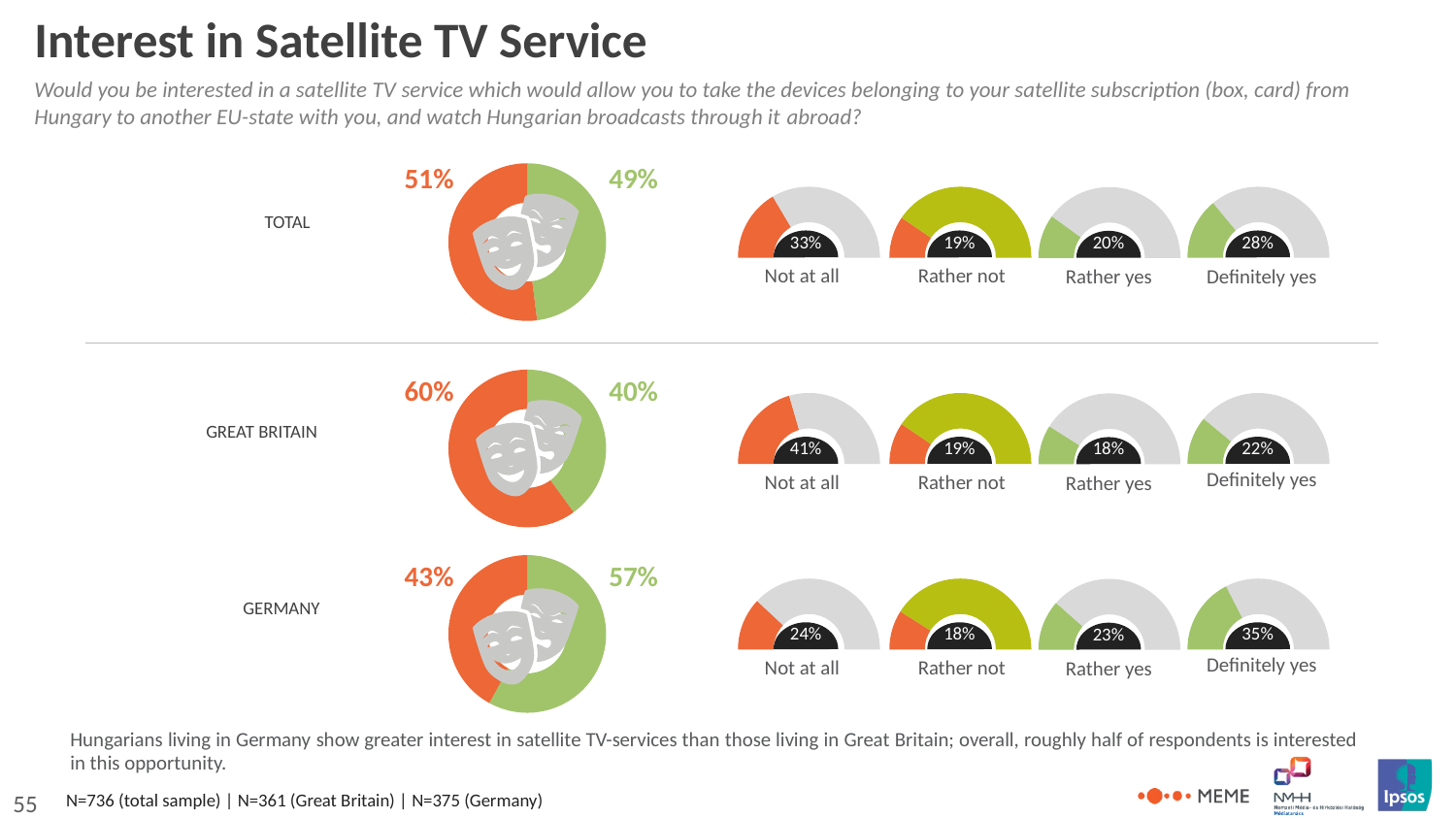
In the GERMANY donut chart, what is the value of the green segment? 57% In the GERMANY row, which of the four answer categories has the highest percentage? Definitely yes In the GREAT BRITAIN row, which of the four answer categories has the lowest percentage? Rather yes How many groups (rows) of charts are shown on the slide? 3 How many answer categories are shown as gauge charts in each row? 4 What is the difference between the "Not at all" and "Definitely yes" percentages in the TOTAL row? 5% In the GERMANY row, what percentage of respondents answered "Definitely yes"? 35% In the GREAT BRITAIN row, what percentage of respondents answered "Rather yes"? 18% In the TOTAL row, what percentage of respondents answered "Not at all"? 33% What is the difference between the "Not at all" percentages for GREAT BRITAIN and GERMANY? 17% Which is larger: the "Definitely yes" percentage for GERMANY or for GREAT BRITAIN? GERMANY In the GREAT BRITAIN donut chart, what is the value of the orange segment? 60%